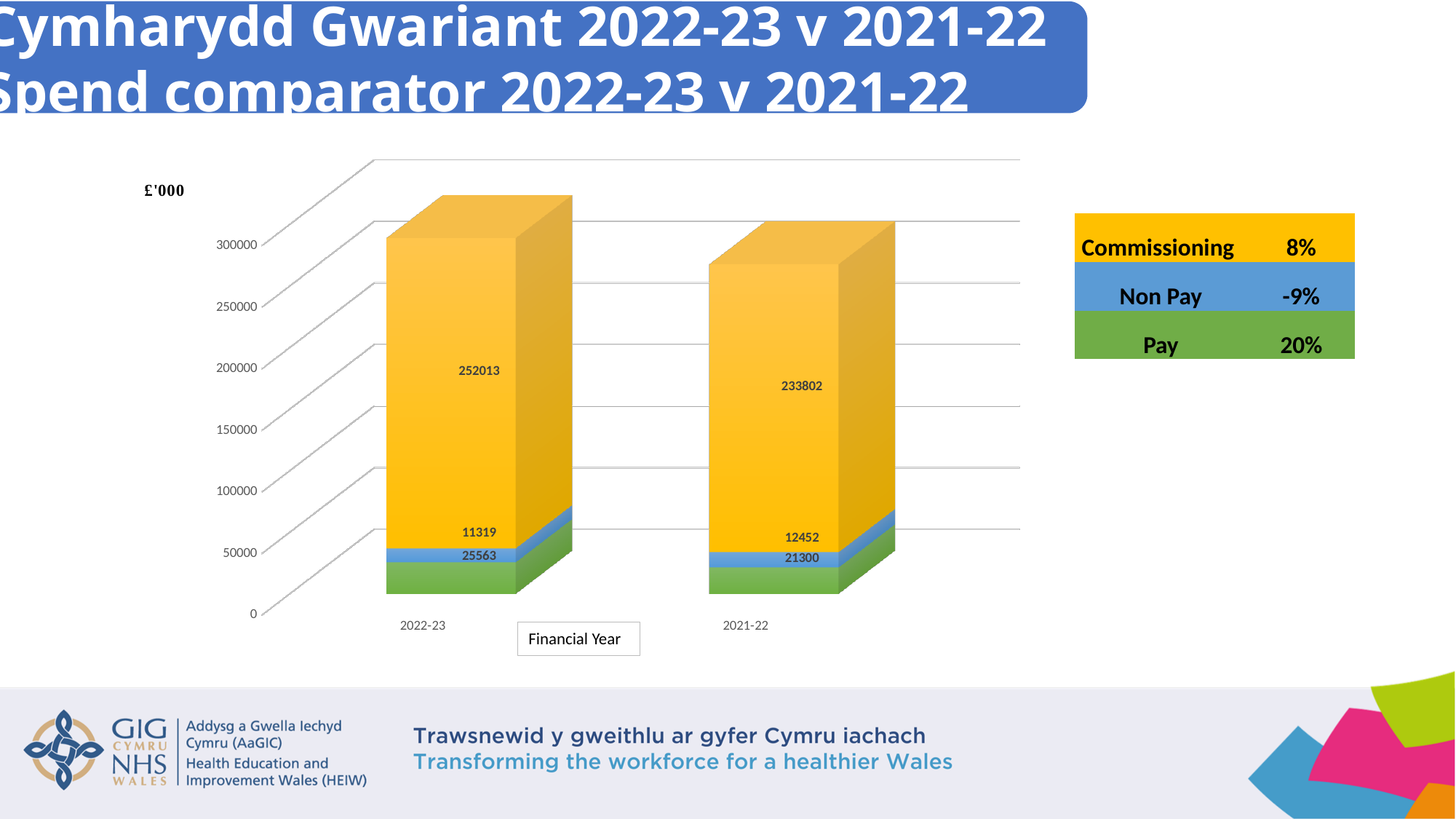
What is the total of the stacked bar for 2022-23? 288895 Which financial year has the higher Commissioning value? 2022-23 Which financial year has the higher Non Pay value? 2021-22 What is the Pay value for 2021-22? 21300 What is the difference between the Pay values for 2022-23 and 2021-22? 4263 How many series does the legend list? 3 What is the Commissioning value for 2022-23? 252013 How many financial years are shown on the x axis? 2 What is the total of the stacked bar for 2021-22? 267554 What is the difference between the Commissioning values for 2022-23 and 2021-22? 18211 What is the Non Pay value for 2022-23? 11319 What is the Commissioning value for 2021-22? 233802